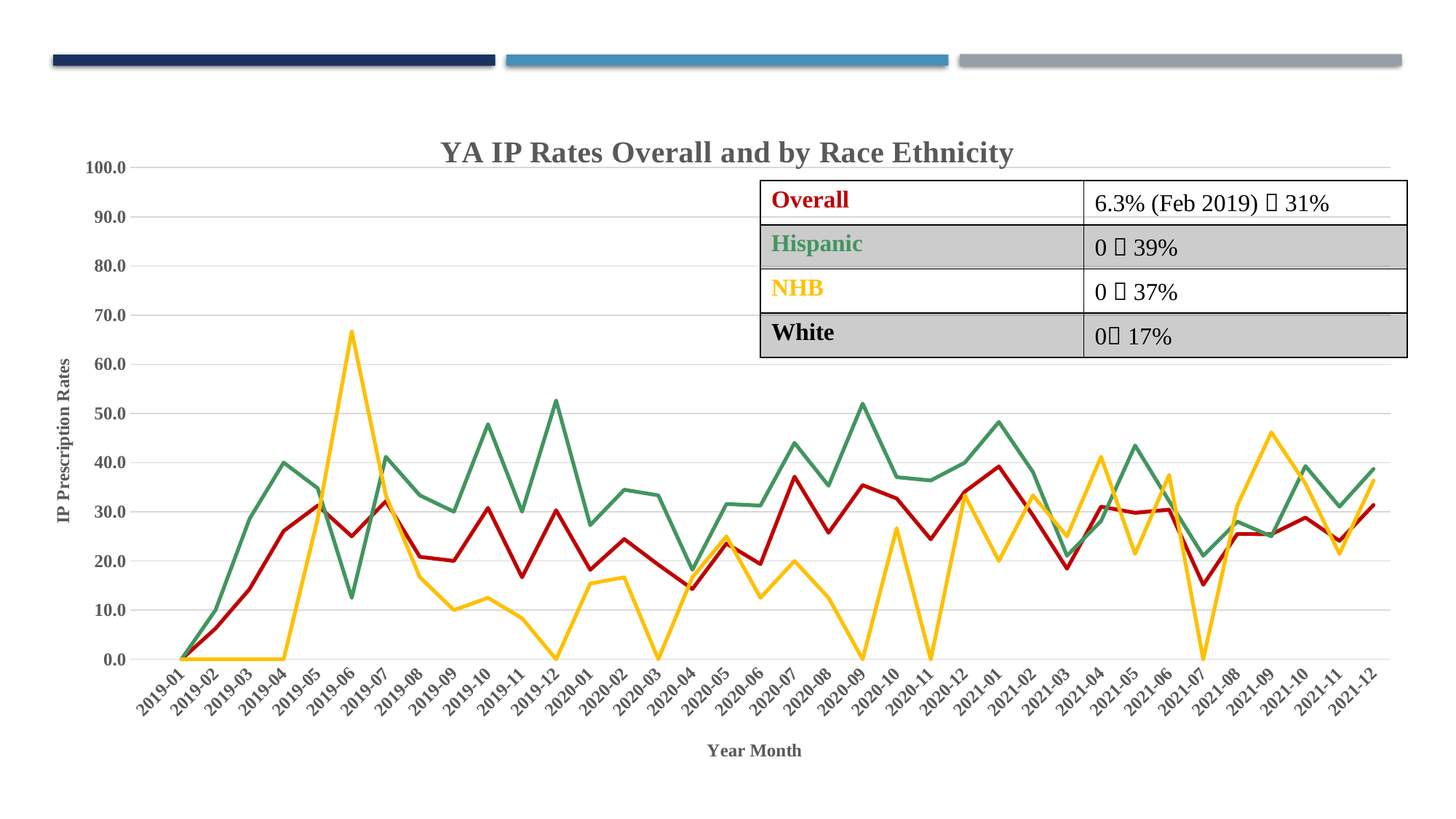
Is the Hispanic value for 2019-12 greater or less than 50.0? greater Is the NHB value for 2019-06 greater or less than 60.0? greater What kind of chart is shown on the slide? line chart Which is larger at 2020-09, the Hispanic value or the NHB value? Hispanic How many months are plotted along the x axis? 36 In which month does the NHB line reach its highest value? 2019-06 What is the label of the y axis? IP Prescription Rates Which is larger at 2019-06, the NHB value or the Hispanic value? NHB What is the title of the chart? YA IP Rates Overall and by Race Ethnicity Is the Overall value for 2021-07 greater or less than 20.0? less What is the NHB value for 2019-03? 0.0 Does the Overall line rise or fall from 2019-01 to 2019-05? rise